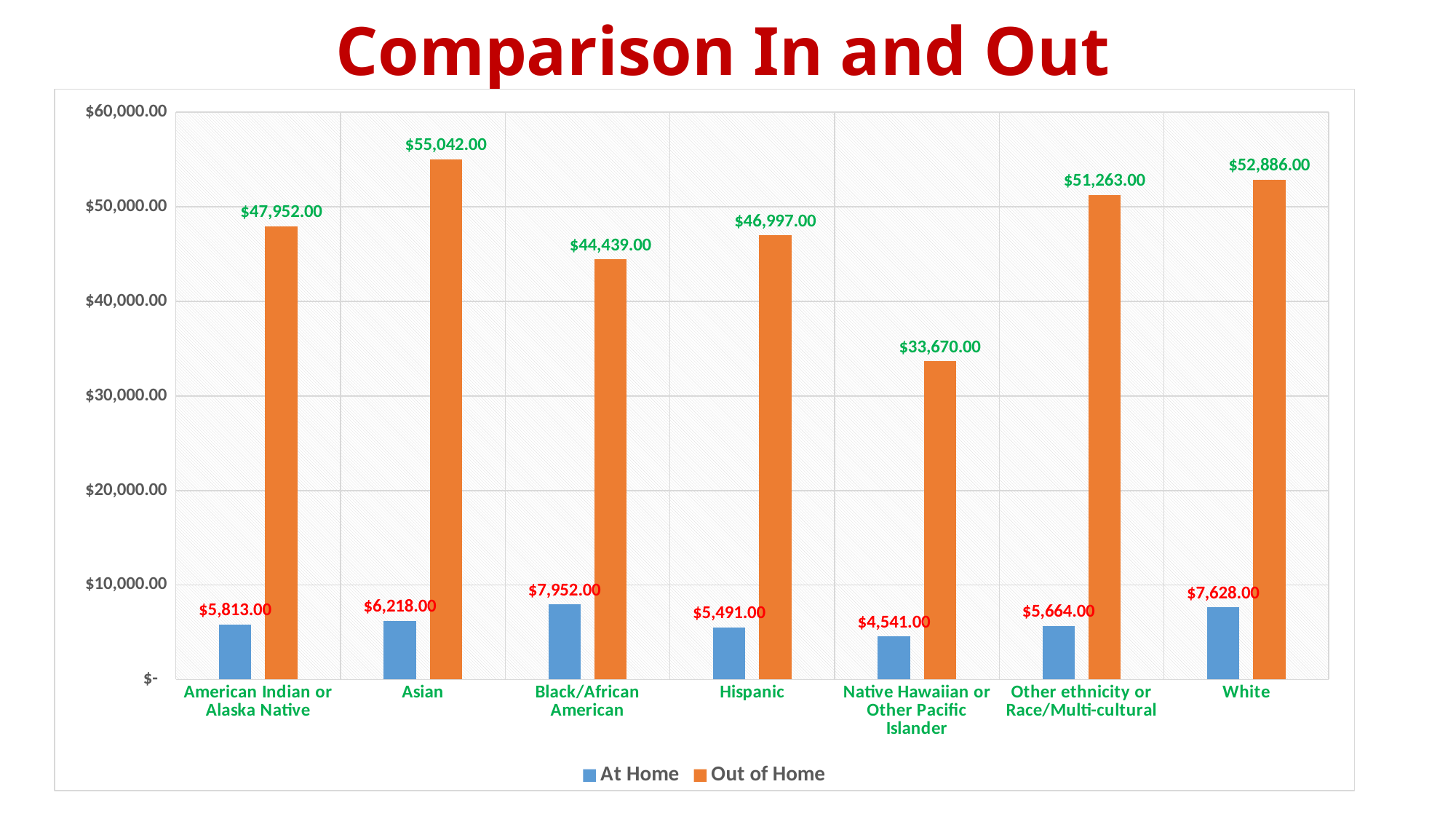
What is the title of the chart? Comparison In and Out What is the Out of Home value for Asian? $55,042.00 Which category has the highest At Home value? Black/African American Which category has the lowest Out of Home value? Native Hawaiian or Other Pacific Islander What is the At Home value for White? $7,628.00 How many categories are shown on the x axis? 7 Which is larger, the Out of Home value for White or the Out of Home value for Other ethnicity or Race/Multi-cultural? White Which category has the highest Out of Home value? Asian What is the difference between the Out of Home and At Home values for Hispanic? $41,506.00 How many series does the legend list? 2 What kind of chart is shown on the slide? Bar chart What is the At Home value for Native Hawaiian or Other Pacific Islander? $4,541.00